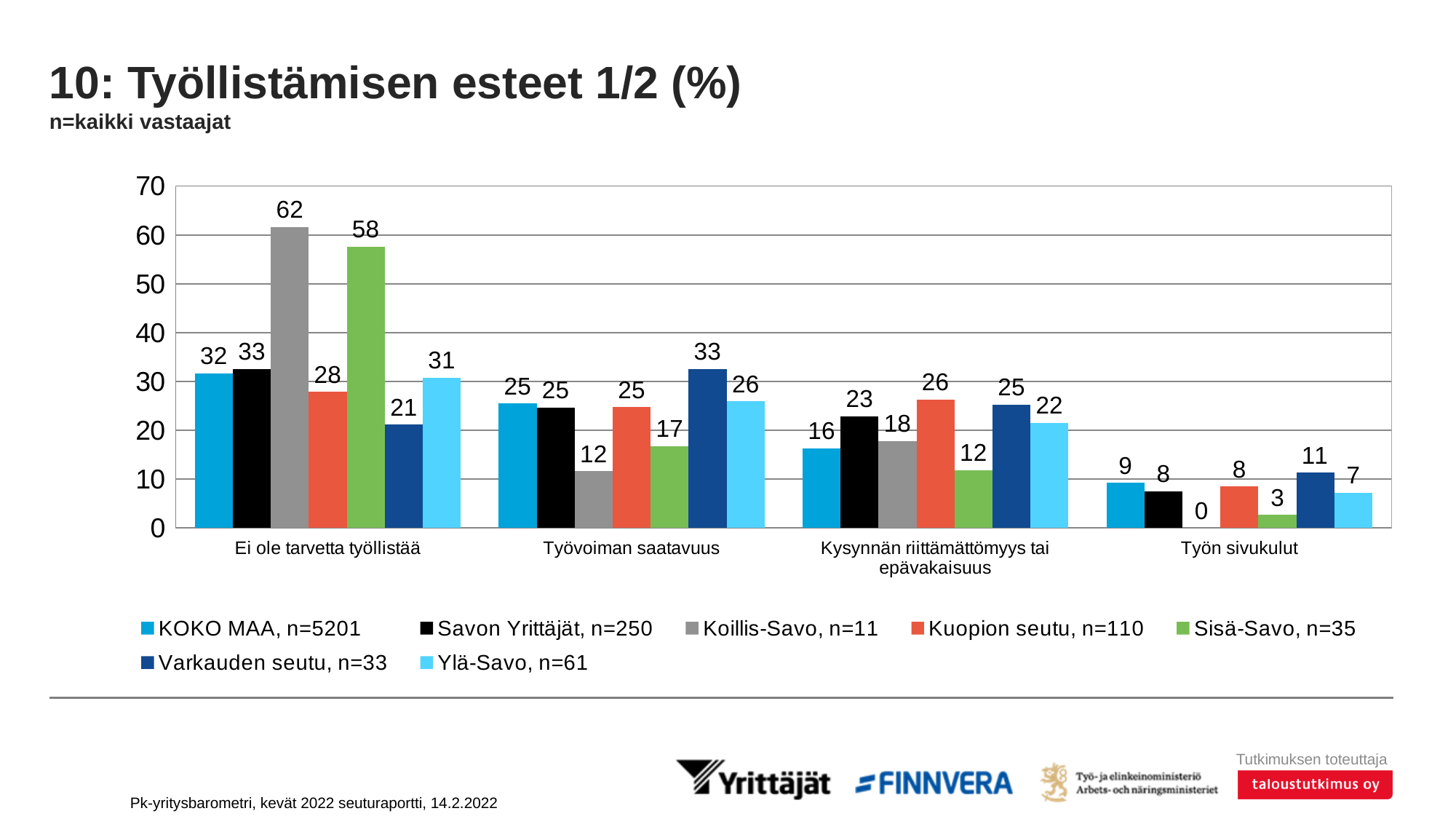
What kind of chart is shown on the slide? Bar chart How many series does the legend list? 7 In the category "Työvoiman saatavuus", which is larger: the value for Koillis-Savo, n=11 or the value for Sisä-Savo, n=35? Sisä-Savo, n=35 What is the value for Koillis-Savo, n=11 in the category "Työn sivukulut"? 0 Which series has the lowest value in the category "Kysynnän riittämättömyys tai epävakaisuus"? Sisä-Savo, n=35 What is the value for Kuopion seutu, n=110 in the category "Kysynnän riittämättömyys tai epävakaisuus"? 26 What is the value for Koillis-Savo, n=11 in the category "Ei ole tarvetta työllistää"? 62 Which series has the highest value in the category "Ei ole tarvetta työllistää"? Koillis-Savo, n=11 What is the value for Varkauden seutu, n=33 in the category "Työvoiman saatavuus"? 33 How many categories are shown on the x axis? 4 What is the title of the slide? 10: Työllistämisen esteet 1/2 (%) What is the difference between the Koillis-Savo, n=11 and Sisä-Savo, n=35 values in the category "Ei ole tarvetta työllistää"? 4